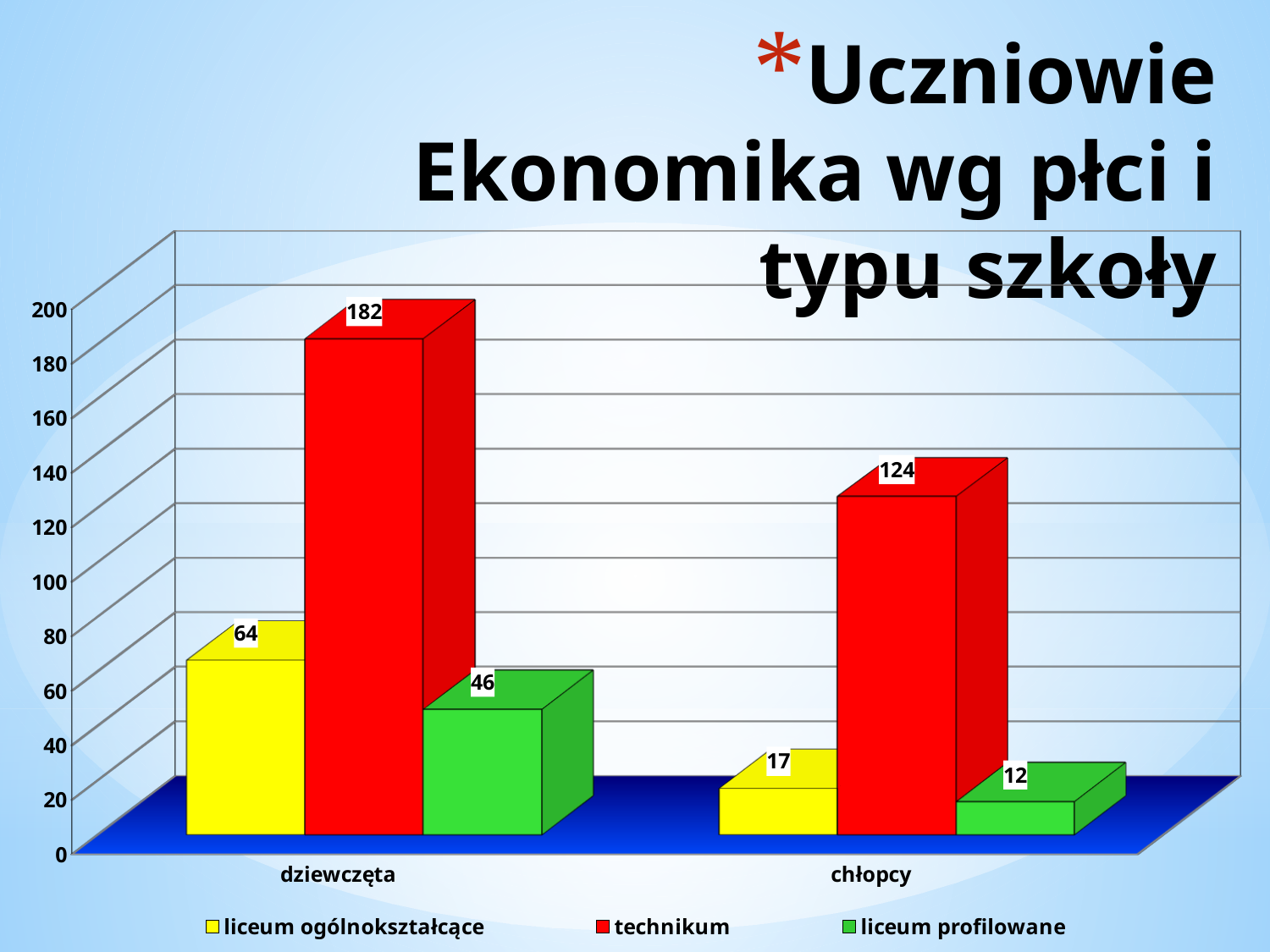
What is the value for technikum among dziewczęta? 182 What kind of chart is shown on the slide? bar chart Which series has the highest value among dziewczęta? technikum What is the value for liceum profilowane among dziewczęta? 46 How many categories are shown on the x axis? 2 How many series does the legend list? 3 What is the difference between the technikum values for dziewczęta and chłopcy? 58 What is the value for technikum among chłopcy? 124 Which colour represents technikum in the chart? red Which is larger: liceum ogólnokształcące for dziewczęta or liceum profilowane for dziewczęta? liceum ogólnokształcące for dziewczęta Which series has the lowest value among chłopcy? liceum profilowane What is the value for liceum ogólnokształcące among chłopcy? 17